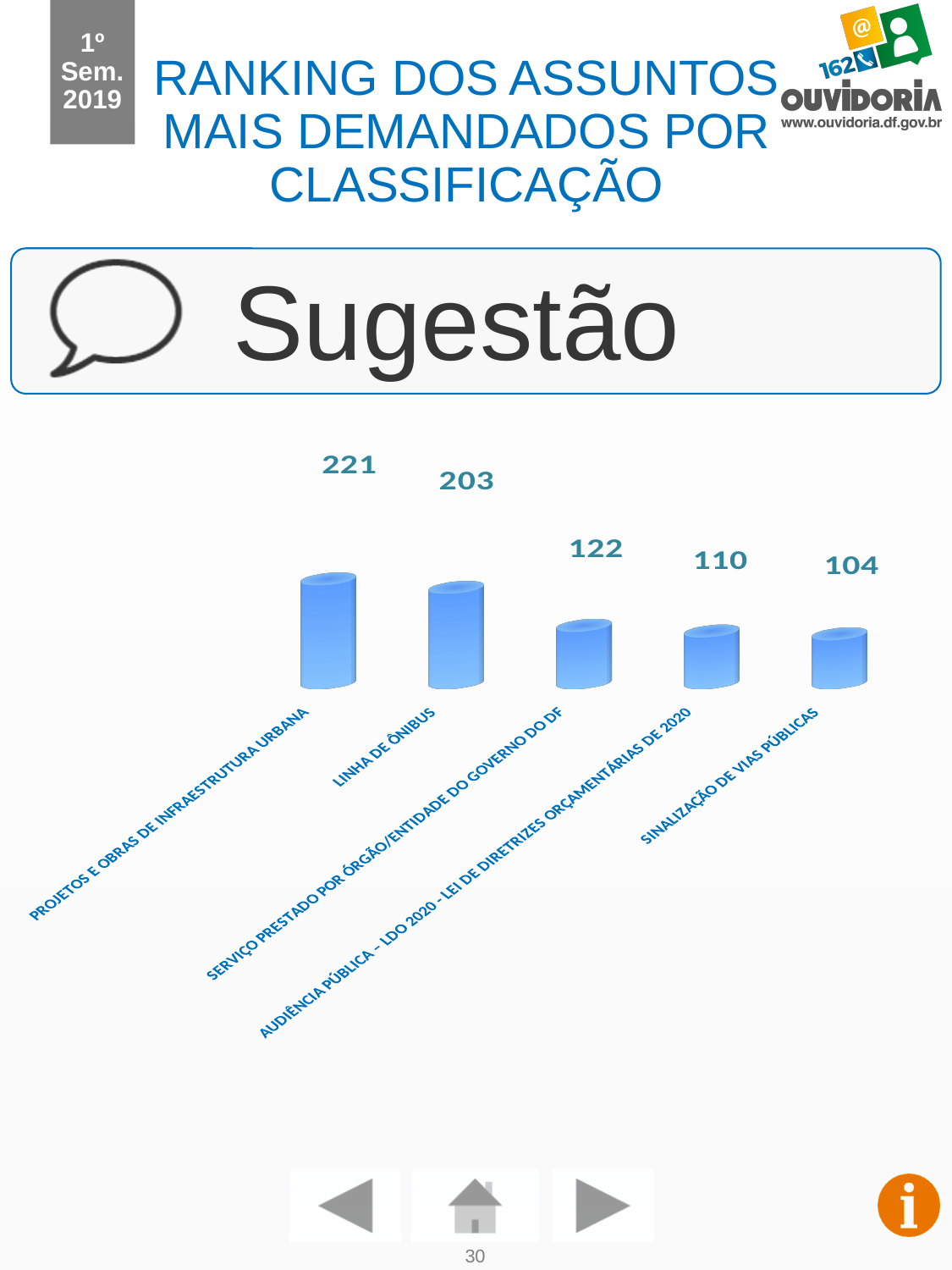
What is the difference between the values for SERVIÇO PRESTADO POR ÓRGÃO/ENTIDADE DO GOVERNO DO DF and SINALIZAÇÃO DE VIAS PÚBLICAS? 18 What is the difference between the values for PROJETOS E OBRAS DE INFRAESTRUTURA URBANA and LINHA DE ÔNIBUS? 18 How many categories are shown in the chart? 5 Which category has the lowest value? SINALIZAÇÃO DE VIAS PÚBLICAS What is the value for SERVIÇO PRESTADO POR ÓRGÃO/ENTIDADE DO GOVERNO DO DF? 122 What is the value for LINHA DE ÔNIBUS? 203 Which classification does the chart on this slide refer to? Sugestão Do the values rise or fall from left to right along the x axis? fall What is the value for SINALIZAÇÃO DE VIAS PÚBLICAS? 104 What kind of chart is shown on the slide? bar chart Which is larger: the value for AUDIÊNCIA PÚBLICA - LDO 2020 - LEI DE DIRETRIZES ORÇAMENTÁRIAS DE 2020 or the value for SINALIZAÇÃO DE VIAS PÚBLICAS? AUDIÊNCIA PÚBLICA - LDO 2020 - LEI DE DIRETRIZES ORÇAMENTÁRIAS DE 2020 Which category has the highest value? PROJETOS E OBRAS DE INFRAESTRUTURA URBANA